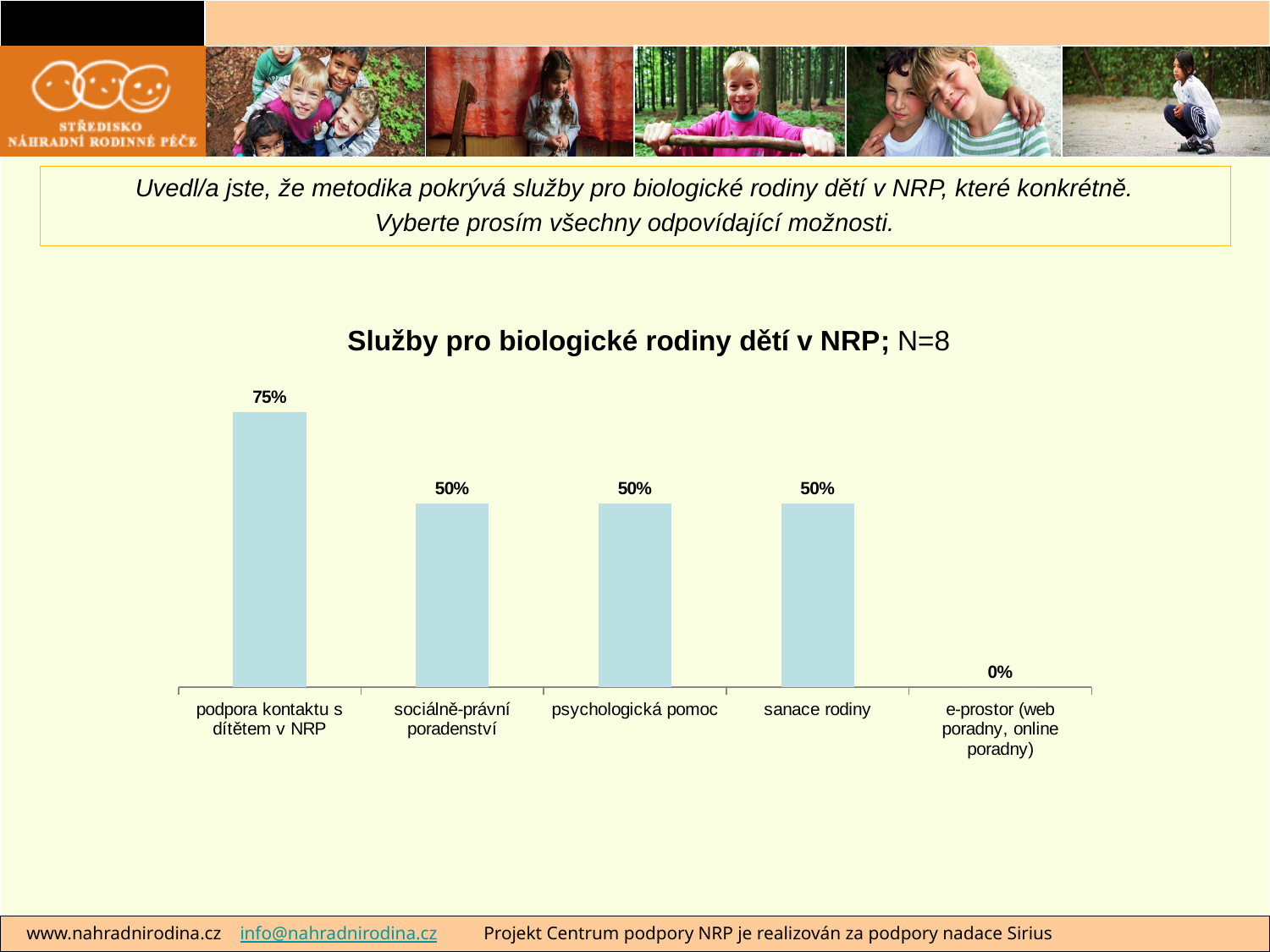
What is the value for 'e-prostor (web poradny, online poradny)'? 0% Which is larger, the value for 'podpora kontaktu s dítětem v NRP' or the value for 'sanace rodiny'? podpora kontaktu s dítětem v NRP How many categories have a value of 50%? 3 Which category has the highest value? podpora kontaktu s dítětem v NRP What is the difference between the values for 'podpora kontaktu s dítětem v NRP' and 'sociálně-právní poradenství'? 25% What is the title of the chart? Služby pro biologické rodiny dětí v NRP; N=8 What kind of chart is shown on the slide? bar chart What is the value for 'psychologická pomoc'? 50% What is the value for 'sanace rodiny'? 50% Which category has the lowest value? e-prostor (web poradny, online poradny) What is the value for 'podpora kontaktu s dítětem v NRP'? 75% How many categories are shown in the chart? 5